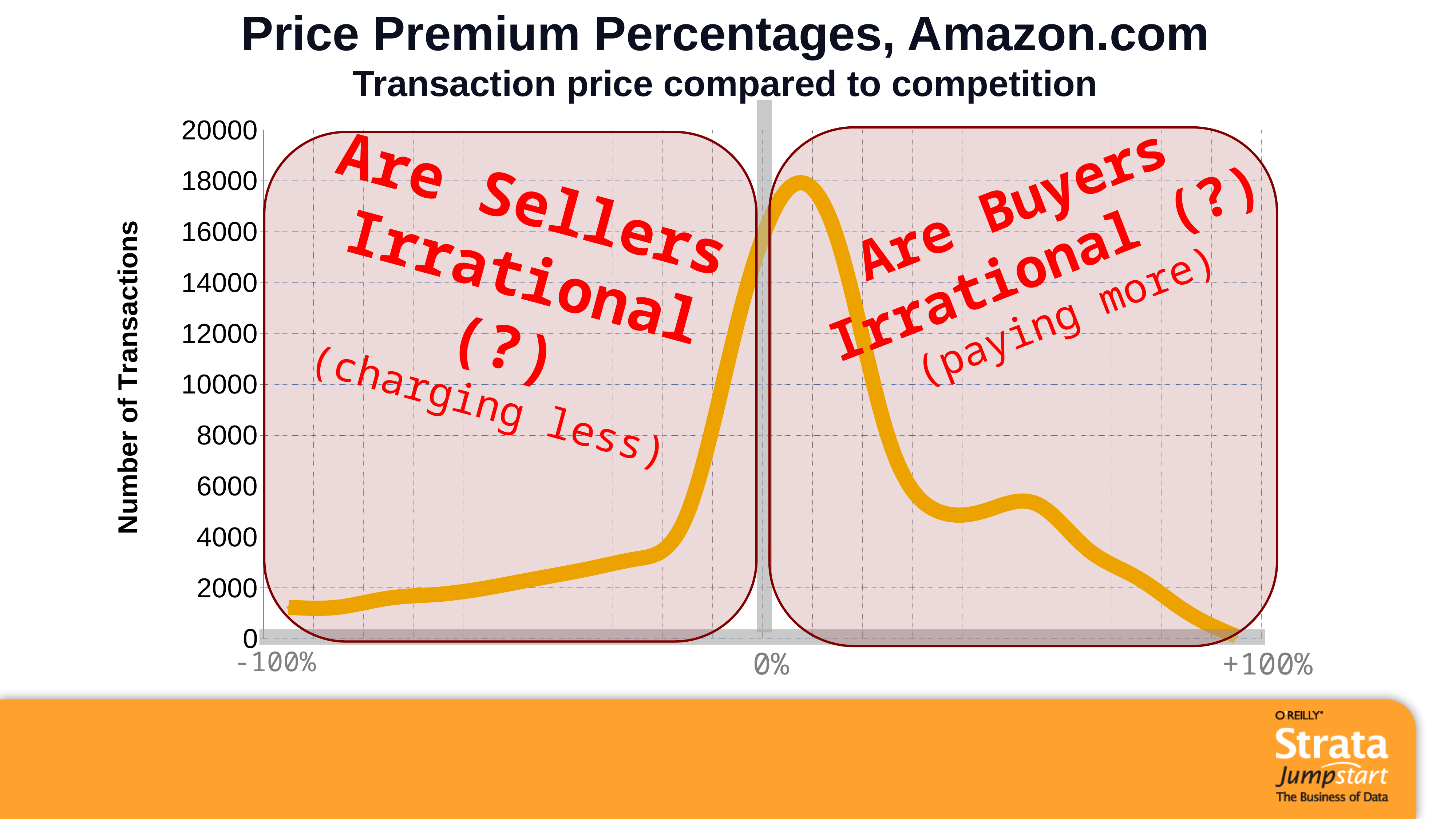
What is the highest value shown on the y axis? 20000 Is the number of transactions at -100% greater or less than 2000? less Is the number of transactions higher at -100% or at +100%? -100% What is the title of the chart? Price Premium Percentages, Amazon.com Do the values rise or fall as the x axis goes from -100% toward 0%? rise What is the label of the y axis? Number of Transactions What are the leftmost and rightmost tick labels on the x axis? -100% and +100% Is the number of transactions at +100% greater or less than 2000? less Is the peak value of the line greater or less than 10000? greater How many lines (series) are plotted on the chart? 1 What kind of chart is shown on the slide? line chart